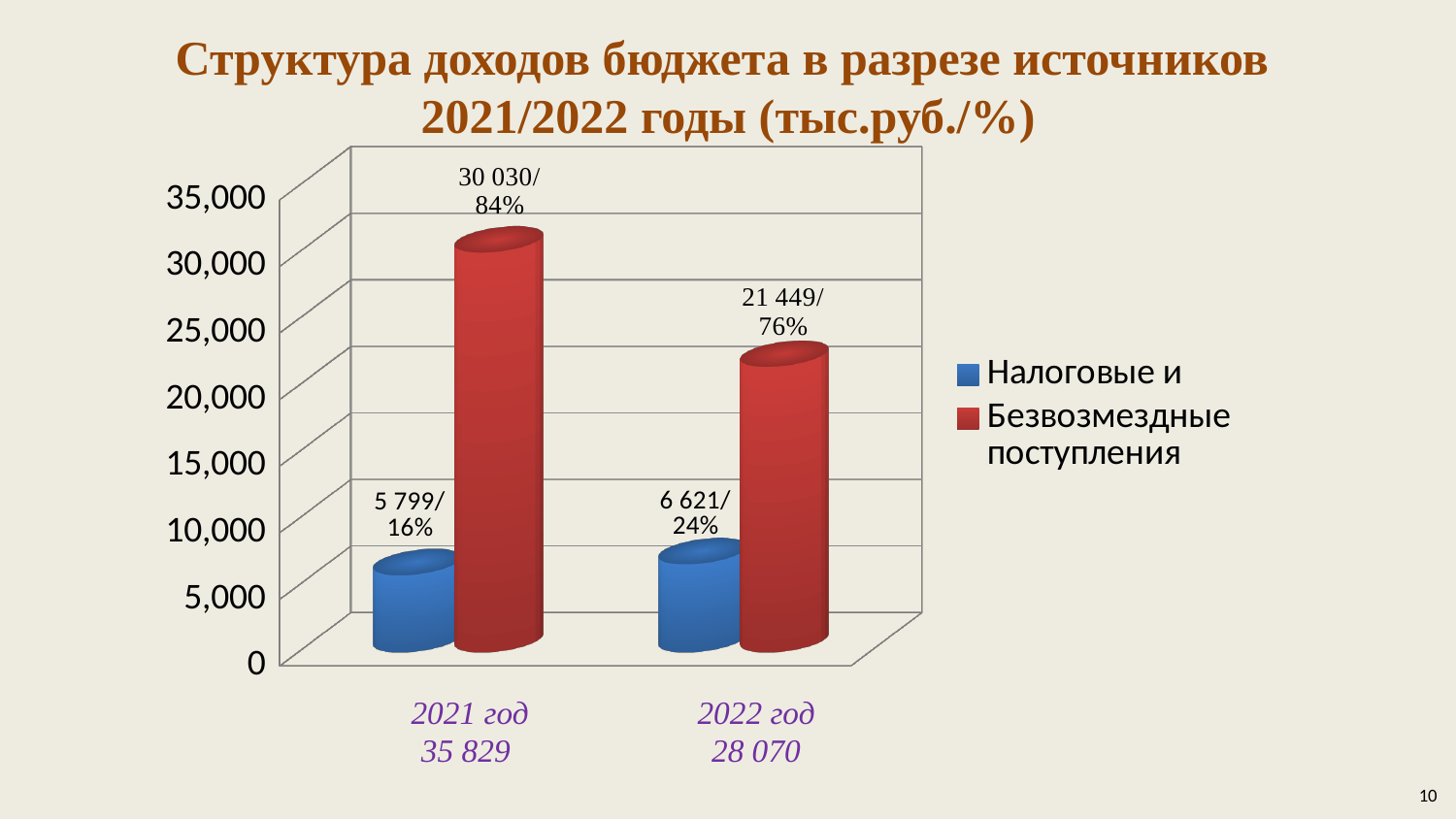
How many year categories are shown on the x axis? 2 Which bar is the lowest on the chart? The blue bar for 2021 год (5 799) What percentage share is shown for Безвозмездные поступления in 2022 год? 76% What value is shown for the blue series in 2021 год? 5 799 Which colour represents Безвозмездные поступления in the legend? Red What total is printed under the 2021 год category? 35 829 Which year has the higher value for Безвозмездные поступления? 2021 год How many series does the legend list? 2 By how much does the Безвозмездные поступления value for 2021 год exceed that for 2022 год? 8 581 What is the data label on the red bar (Безвозмездные поступления) for 2021 год? 30 030/ 84% What type of chart is shown on the slide? Bar chart What is the data label on the blue bar for 2022 год? 6 621/ 24%